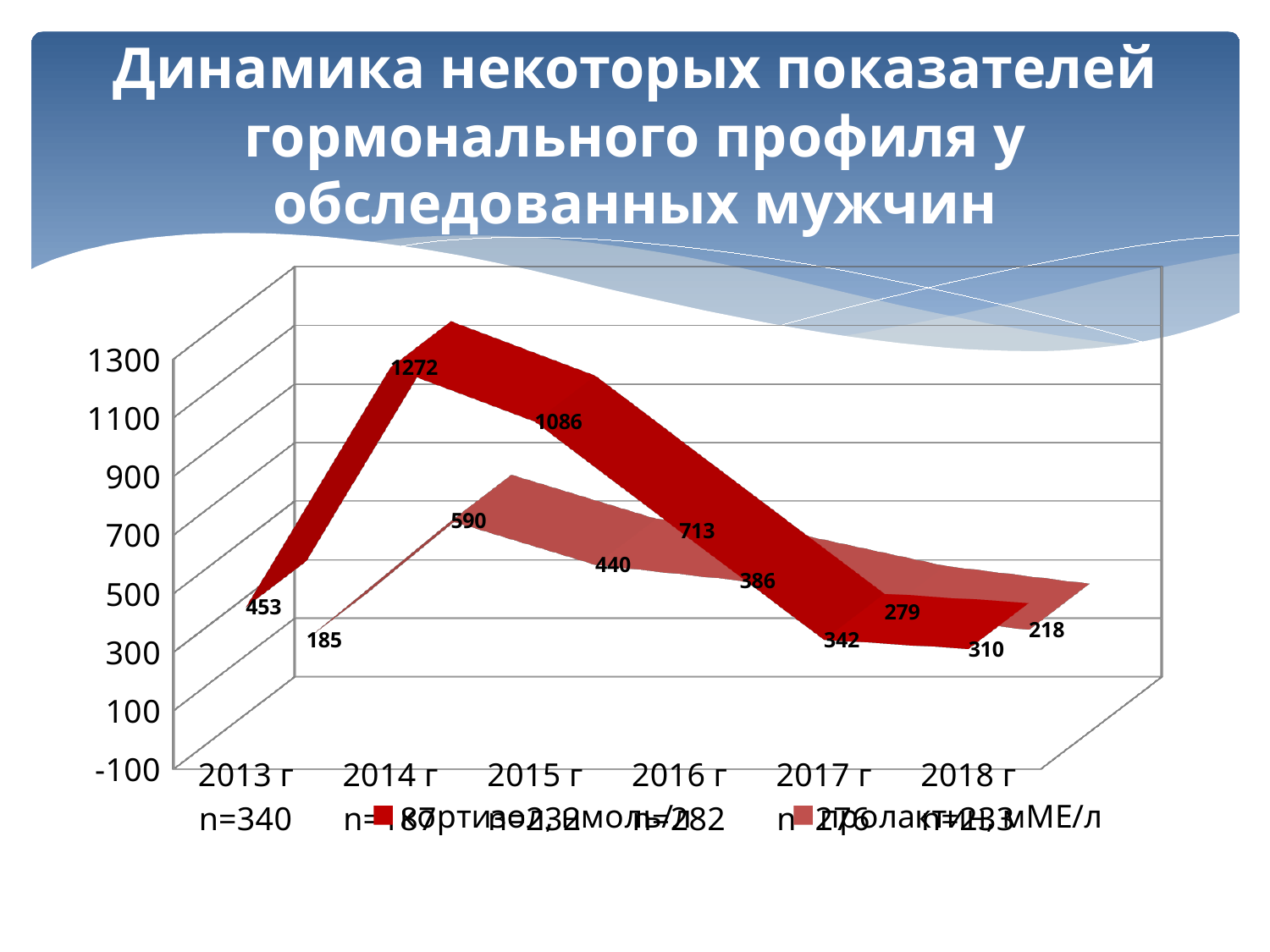
How many years are shown on the x axis? 6 What is the value of the dark red series for 2014 г? 1272 What is the difference between the dark red series values for 2014 г and 2015 г? 186 In which year does the dark red series have its lowest value? 2018 г How many series does the chart plot? 2 For 2016 г, which series has the larger value, the dark red or the lighter red? dark red What type of chart is shown on the slide? 3D line chart What is the value of the lighter red series for 2018 г? 218 In which year does the dark red series reach its highest value? 2014 г What is the difference between the lighter red series values for 2014 г and 2013 г? 405 In which year does the lighter red series have its lowest value? 2013 г What is the value of the lighter red series for 2013 г? 185